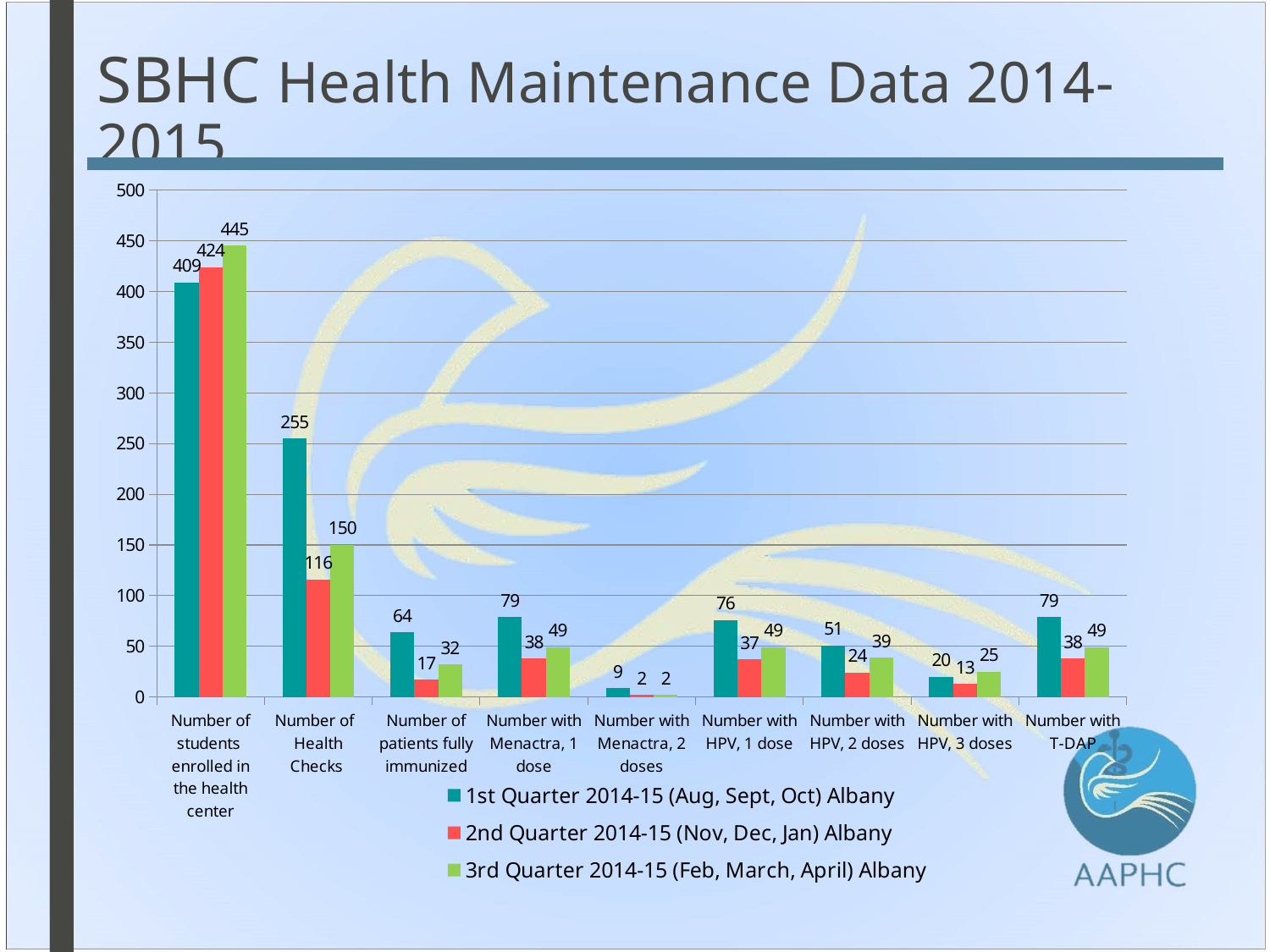
Is the 1st Quarter value for Number of patients fully immunized greater or less than 50? greater What is the value for Number of Health Checks in the 1st Quarter 2014-15 (Aug, Sept, Oct) Albany series? 255 What kind of chart is shown on the slide? Bar chart Which is larger for Number with HPV, 3 doses: the 1st Quarter value or the 3rd Quarter value? 3rd Quarter Which category has the lowest value in the 3rd Quarter 2014-15 (Feb, March, April) Albany series? Number with Menactra, 2 doses What is the difference between the 3rd Quarter and 1st Quarter values for Number of students enrolled in the health center? 36 Which category has the highest value in the 1st Quarter 2014-15 (Aug, Sept, Oct) Albany series? Number of students enrolled in the health center How many series does the legend list? 3 What is the value for Number with HPV, 2 doses in the 2nd Quarter 2014-15 (Nov, Dec, Jan) Albany series? 24 What is the difference between the 1st Quarter and 2nd Quarter values for Number of Health Checks? 139 What is the value for Number of students enrolled in the health center in the 3rd Quarter 2014-15 (Feb, March, April) Albany series? 445 How many categories are shown on the x axis? 9